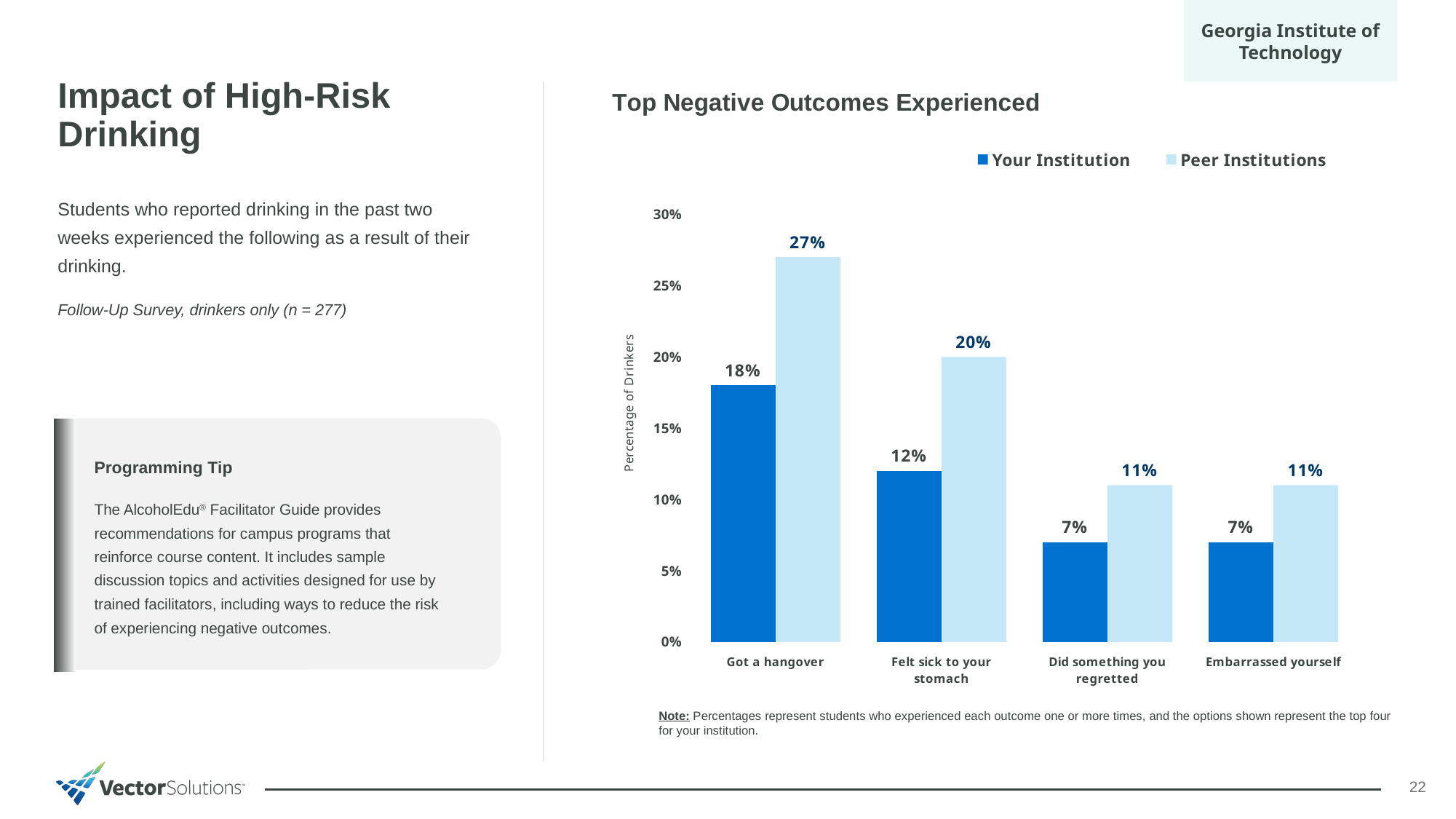
What is the value for Your Institution for 'Got a hangover'? 18% Which category has the lowest Your Institution value? Did something you regretted and Embarrassed yourself (both 7%) Which is larger for 'Felt sick to your stomach': Your Institution or Peer Institutions? Peer Institutions What is the value for Peer Institutions for 'Felt sick to your stomach'? 20% What is the difference between Peer Institutions and Your Institution for 'Got a hangover'? 9% What kind of chart is shown? Bar chart Do the Your Institution values rise or fall from left to right across the categories? Fall Which category has the highest Peer Institutions value? Got a hangover How many categories are shown on the x axis? 4 What is the title of the chart? Top Negative Outcomes Experienced What is the value for Your Institution for 'Did something you regretted'? 7% How many series does the legend list? 2